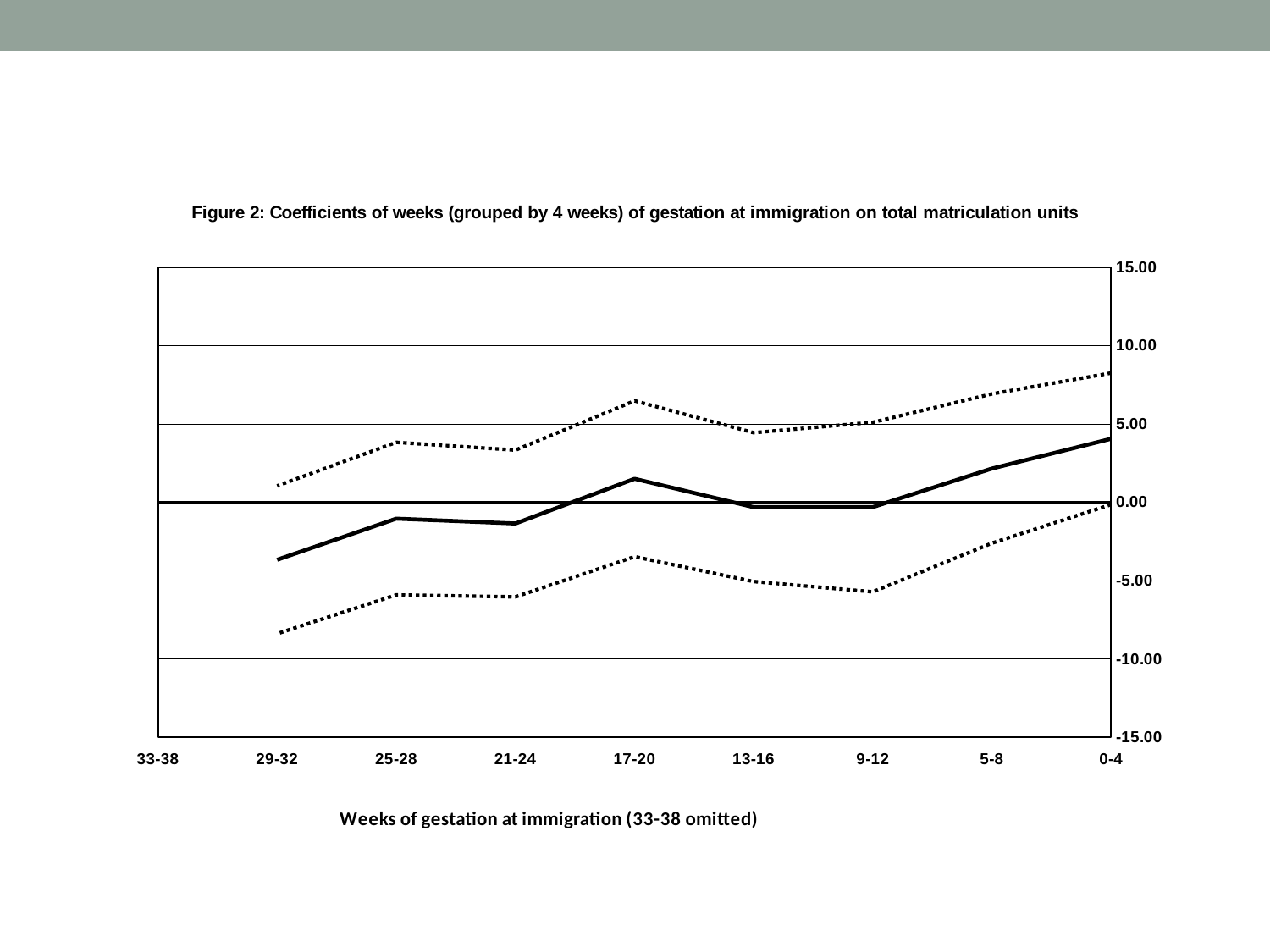
What is the x-axis title of the chart? Weeks of gestation at immigration (33-38 omitted) Is the value of the upper dotted line at 0-4 greater or less than 5.00? greater At which x-axis category does the solid line reach its lowest value? 29-32 Is the value of the solid line at 0-4 greater or less than 0.00? greater Is the value of the upper dotted line at 17-20 greater or less than 5.00? greater How many category labels appear on the x axis? 9 What kind of chart is shown on the slide? line chart At which x-axis category does the solid line reach its highest value? 0-4 What is the title of the chart? Figure 2: Coefficients of weeks (grouped by 4 weeks) of gestation at immigration on total matriculation units Does the solid line generally rise or fall moving from 29-32 to 0-4 along the x axis? rise